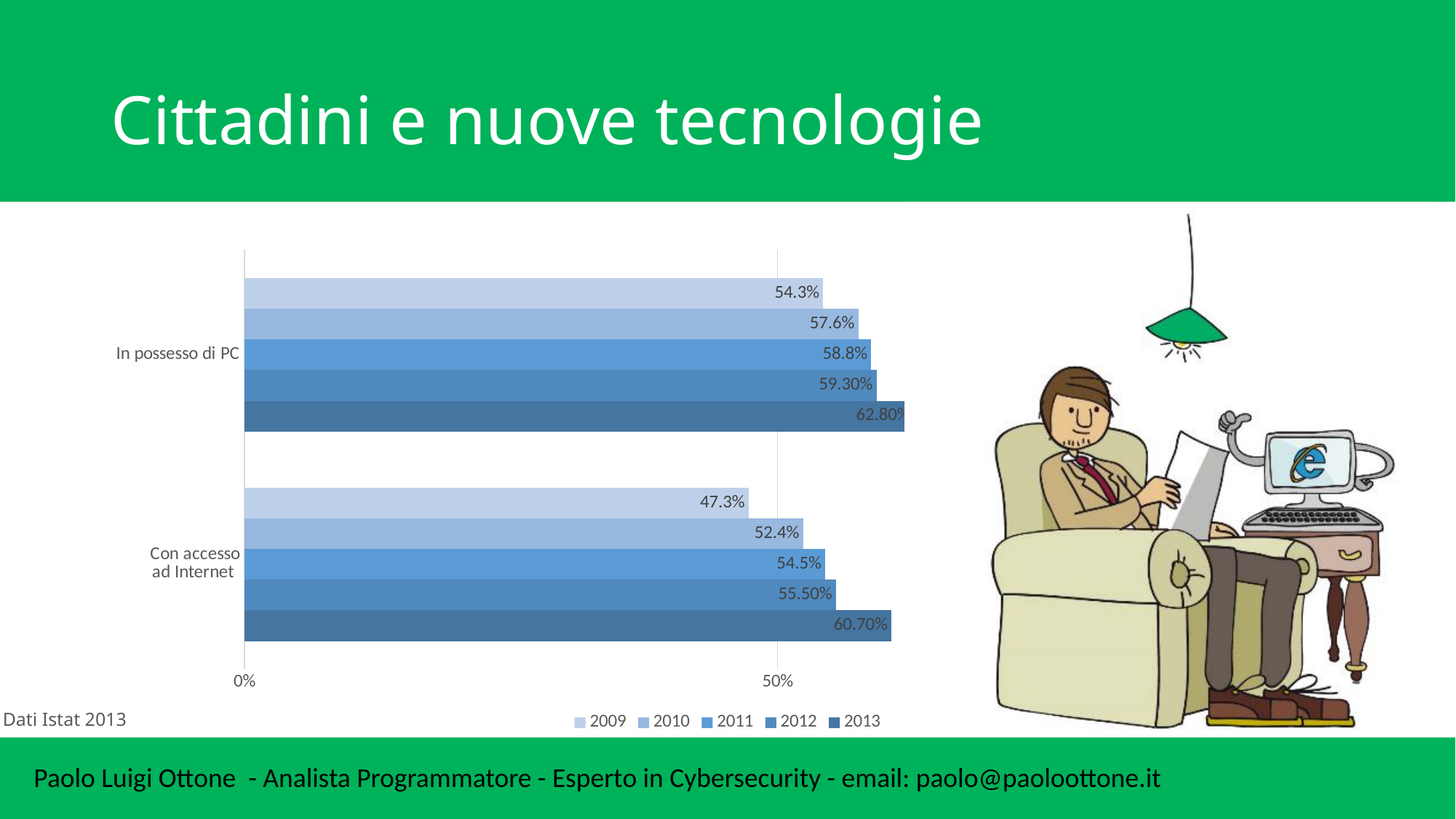
Which year has the highest value in the 'Con accesso ad Internet' category? 2013 Which is larger: the 2010 value for 'In possesso di PC' or the 2010 value for 'Con accesso ad Internet'? In possesso di PC What is the difference between the 2013 and 2009 values in the 'In possesso di PC' category? 8.5% What is the value for 2013 in the 'In possesso di PC' category? 62.80% How many series does the legend list? 5 What kind of chart is shown on the slide? bar chart How many categories are shown on the chart? 2 Which year has the lowest value in the 'In possesso di PC' category? 2009 Is the 2009 value for 'Con accesso ad Internet' greater or less than 50%? less What is the value for 2009 in the 'Con accesso ad Internet' category? 47.3% What is the value for 2012 in the 'Con accesso ad Internet' category? 55.50% What is the value for 2011 in the 'In possesso di PC' category? 58.8%